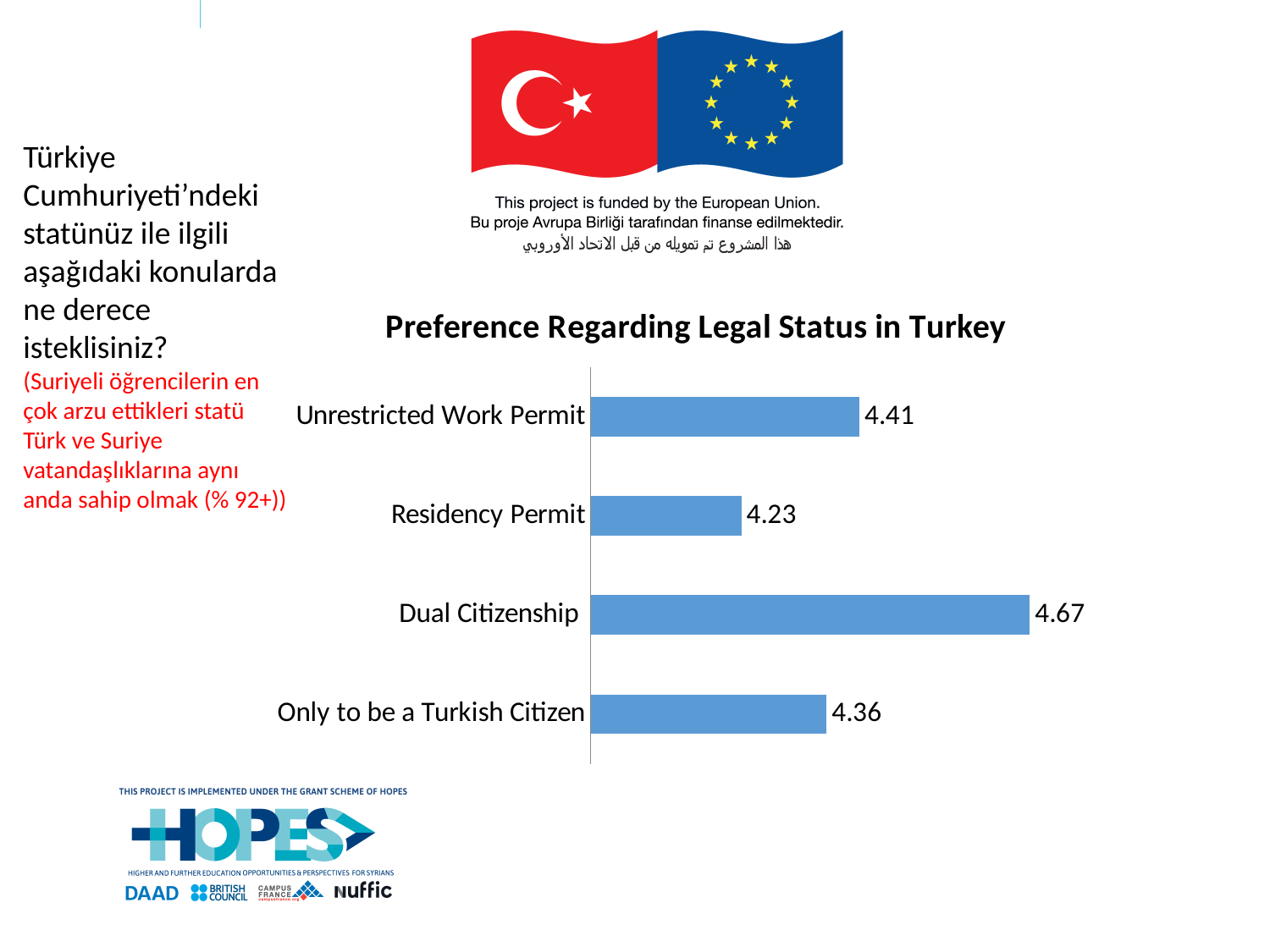
What is the value for Only to be a Turkish Citizen? 4.36 Which category has the highest value? Dual Citizenship What is the title of the chart? Preference Regarding Legal Status in Turkey What is the difference between the values for Unrestricted Work Permit and Only to be a Turkish Citizen? 0.05 What is the value for Unrestricted Work Permit? 4.41 What is the difference between the values for Dual Citizenship and Residency Permit? 0.44 How many categories are shown in the chart? 4 What is the value for Dual Citizenship? 4.67 What kind of chart is shown on the slide? Bar chart Which category has the lowest value? Residency Permit Which is larger, the value for Unrestricted Work Permit or the value for Residency Permit? Unrestricted Work Permit What is the value for Residency Permit? 4.23